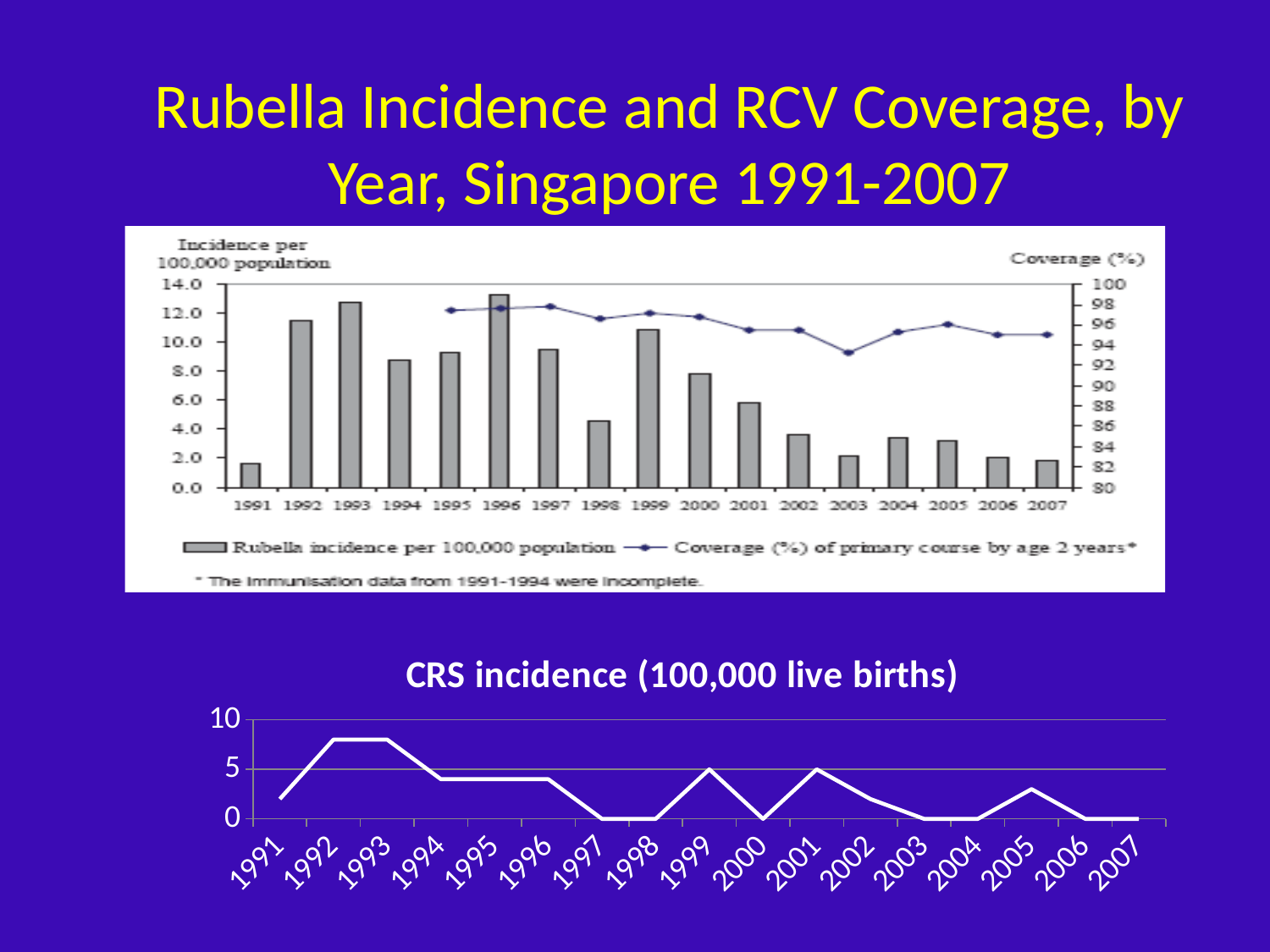
In the top chart (Rubella Incidence and RCV Coverage), which year has the highest rubella incidence bar? 1996 In the top chart (Rubella Incidence and RCV Coverage), which year has the lowest coverage (%) value on the line? 2003 In the bottom chart (CRS incidence), what is the value for 1999? 5 According to the footnote of the top chart, the immunisation data from which years were incomplete? 1991-1994 How many years are shown on the x axis of the top chart (Rubella Incidence and RCV Coverage)? 17 In the bottom chart (CRS incidence), is the value for 1992 greater or less than 5? greater In the top chart (Rubella Incidence and RCV Coverage), is the rubella incidence for 1998 greater or less than 6.0? less What type of chart is the bottom chart titled 'CRS incidence (100,000 live births)'? line chart In the top chart (Rubella Incidence and RCV Coverage), which year has the higher rubella incidence, 1999 or 2000? 1999 In the bottom chart (CRS incidence), what is the value for 1997? 0 How many series does the legend of the top chart (Rubella Incidence and RCV Coverage) list? 2 In the top chart (Rubella Incidence and RCV Coverage), is the rubella incidence for 1992 greater or less than 10.0? greater